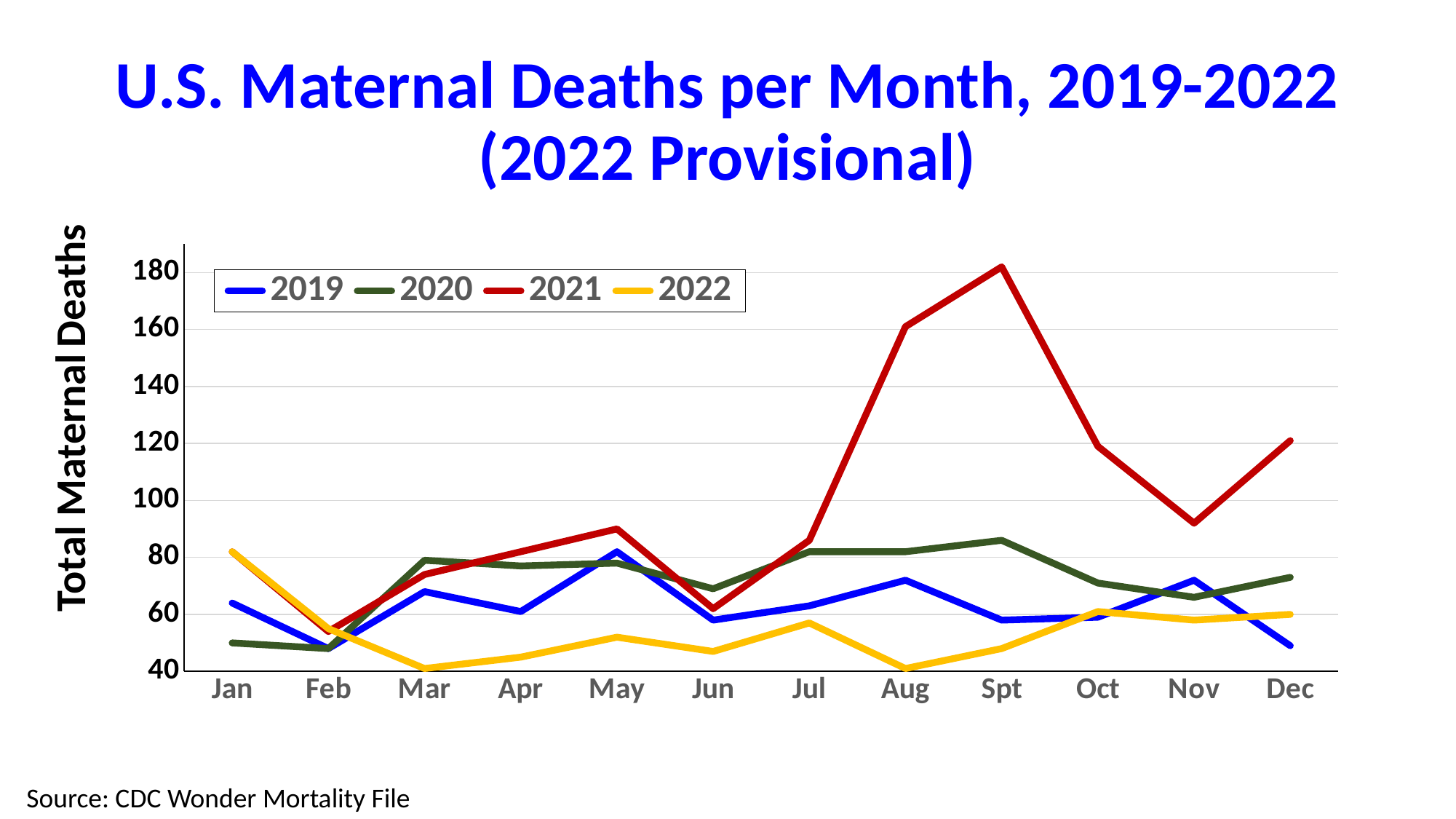
Which year's line has the lowest value in Jan? 2020 In Jan, which is larger: the value for 2022 or the value for 2020? 2022 Is the value for 2019 in Dec greater or less than 60? less Does the 2021 line rise or fall from Jul to Spt? rise How many months are plotted along the x axis? 12 In which month does the 2021 line reach its highest value? Spt Is the value for 2021 in Spt greater or less than 160? greater What is the title of the chart? U.S. Maternal Deaths per Month, 2019-2022 (2022 Provisional) What kind of chart is shown on the slide? Line chart Is the value for 2020 in Jan greater or less than 60? less How many series does the legend list? 4